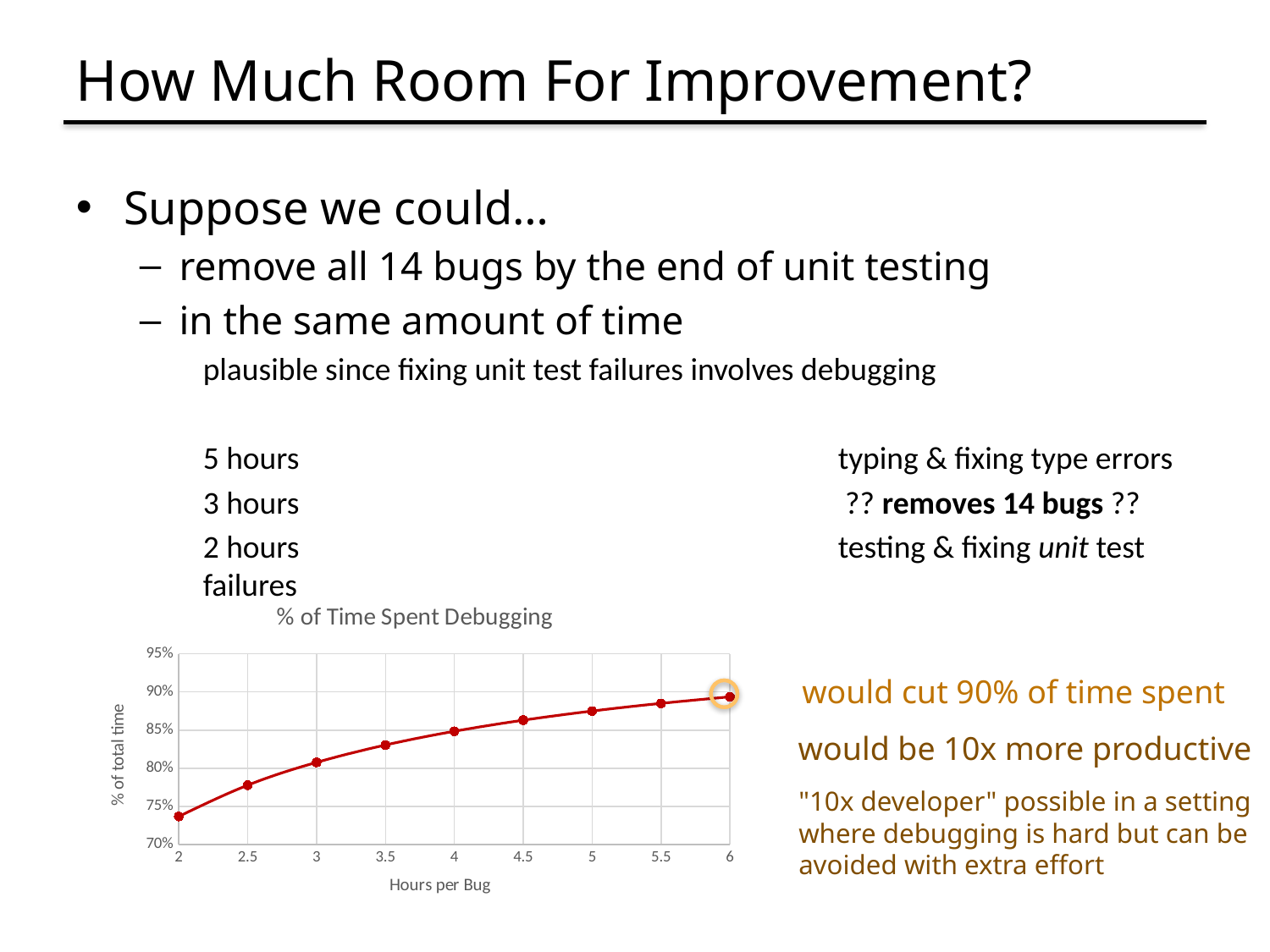
Is the value at 6 Hours per Bug greater or less than 85%? greater Do the values rise or fall as Hours per Bug increases? rise What kind of chart is shown on the slide? line chart Which Hours per Bug value has the highest % of total time? 6 Which is larger, the value at 3.5 Hours per Bug or the value at 5 Hours per Bug? 5 Hours per Bug What is the title of the chart? % of Time Spent Debugging What is the label of the x axis of the chart? Hours per Bug Is the value at 3 Hours per Bug greater or less than 85%? less Is the value at 2 Hours per Bug greater or less than 75%? less Which Hours per Bug value has the lowest % of total time? 2 How many data points are plotted on the line? 9